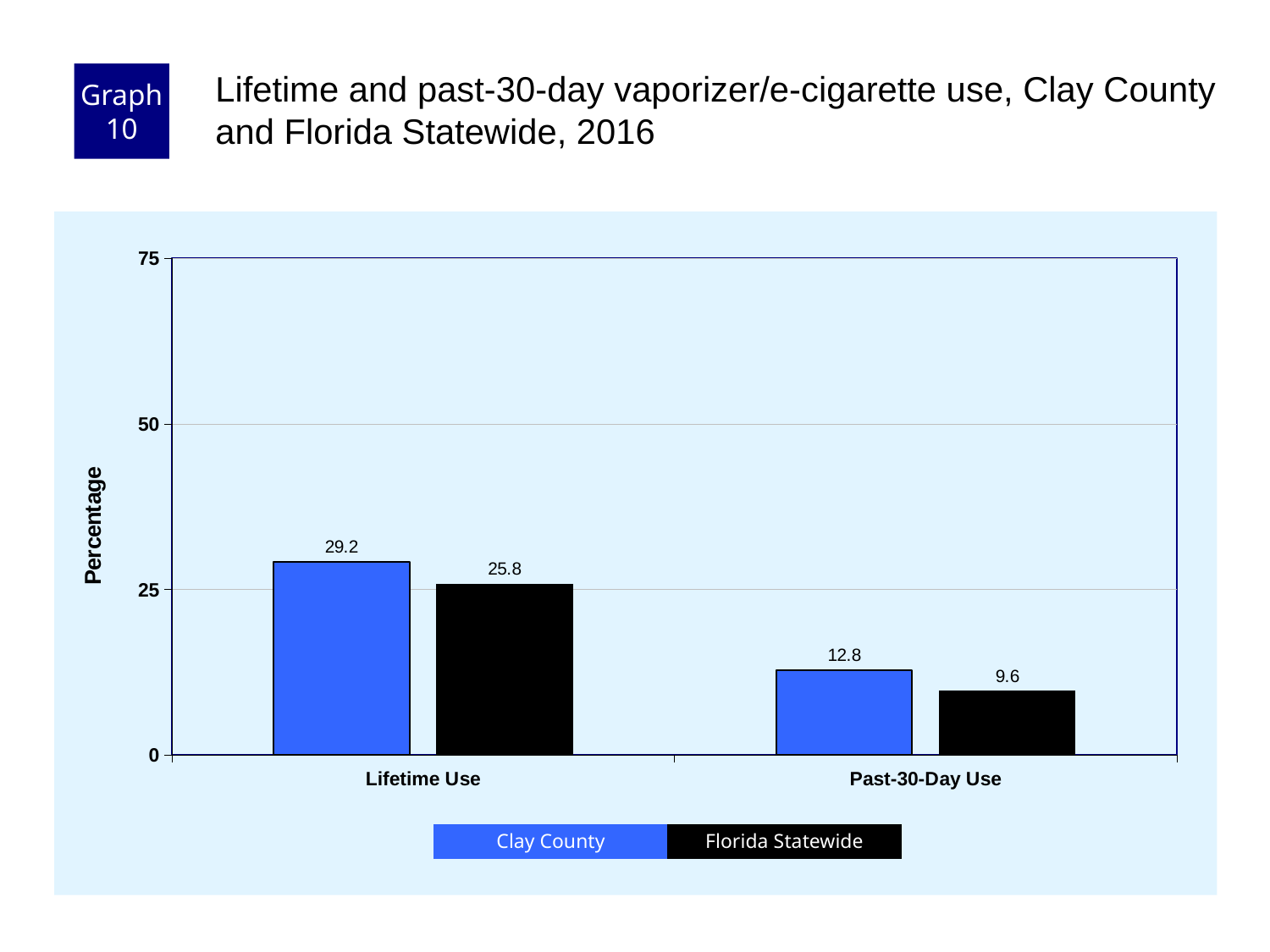
What is the difference between the Clay County and Florida Statewide values for Past-30-Day Use? 3.2 What kind of chart is shown on the slide? bar chart Which category has the highest Clay County value? Lifetime Use Which bar has the lowest value on the chart? Florida Statewide, Past-30-Day Use What is the Clay County value for Lifetime Use? 29.2 What is the Florida Statewide value for Past-30-Day Use? 9.6 What is the difference between the Clay County and Florida Statewide values for Lifetime Use? 3.4 What is the Florida Statewide value for Lifetime Use? 25.8 How many categories are shown on the x axis? 2 For Past-30-Day Use, which is larger: Clay County or Florida Statewide? Clay County Is the Clay County value for Lifetime Use greater or less than 25? greater How many series does the legend list? 2